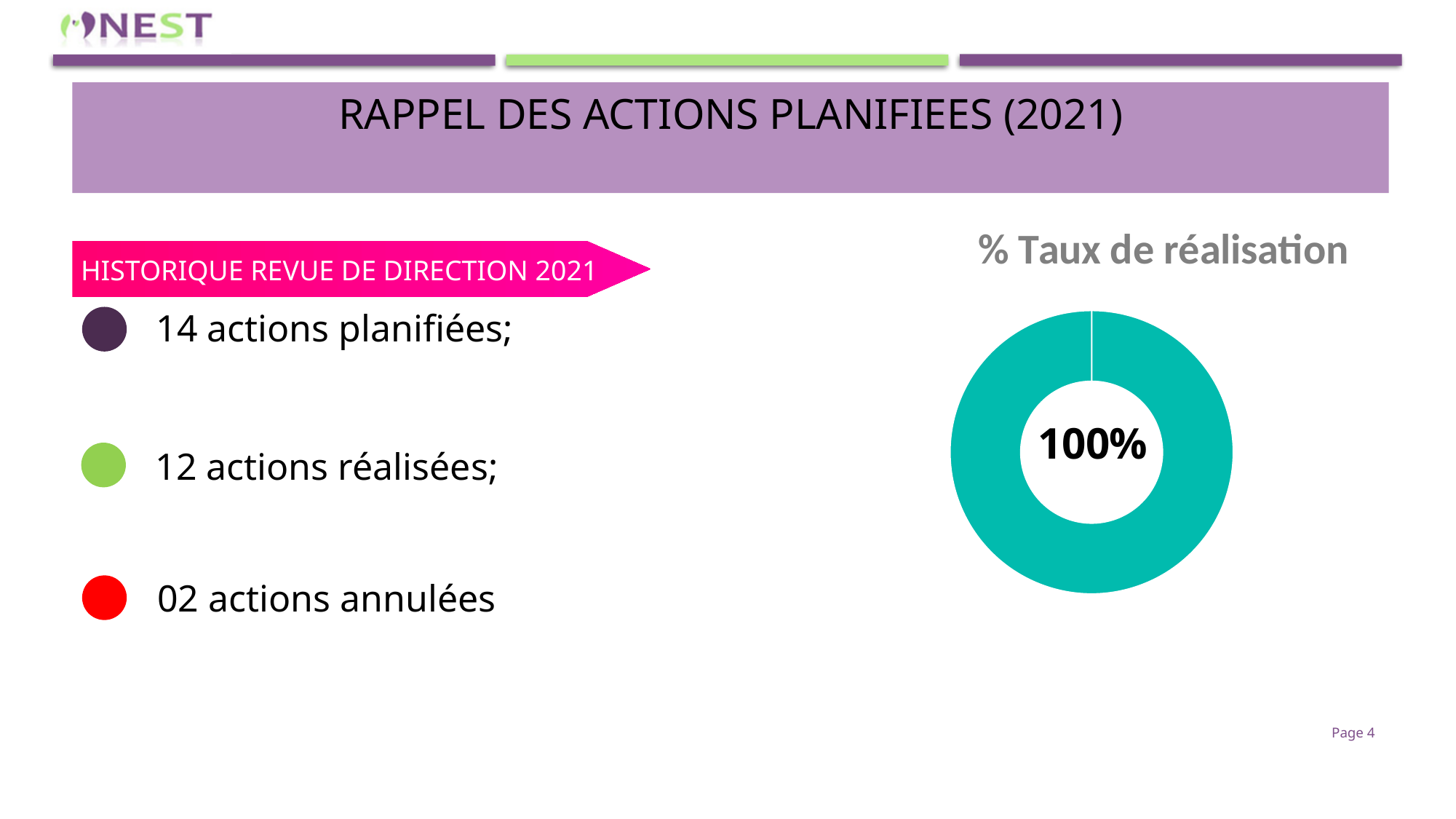
What colour is the slice of the doughnut chart? Teal What is the title of the chart on the slide? % Taux de réalisation What kind of chart is shown on the slide? Doughnut chart What value is printed in the centre of the doughnut chart? 100% How many slices does the doughnut chart contain? 1 What share of the doughnut chart does the single slice occupy? 100% Is the value shown in the doughnut chart greater or less than 50%? greater